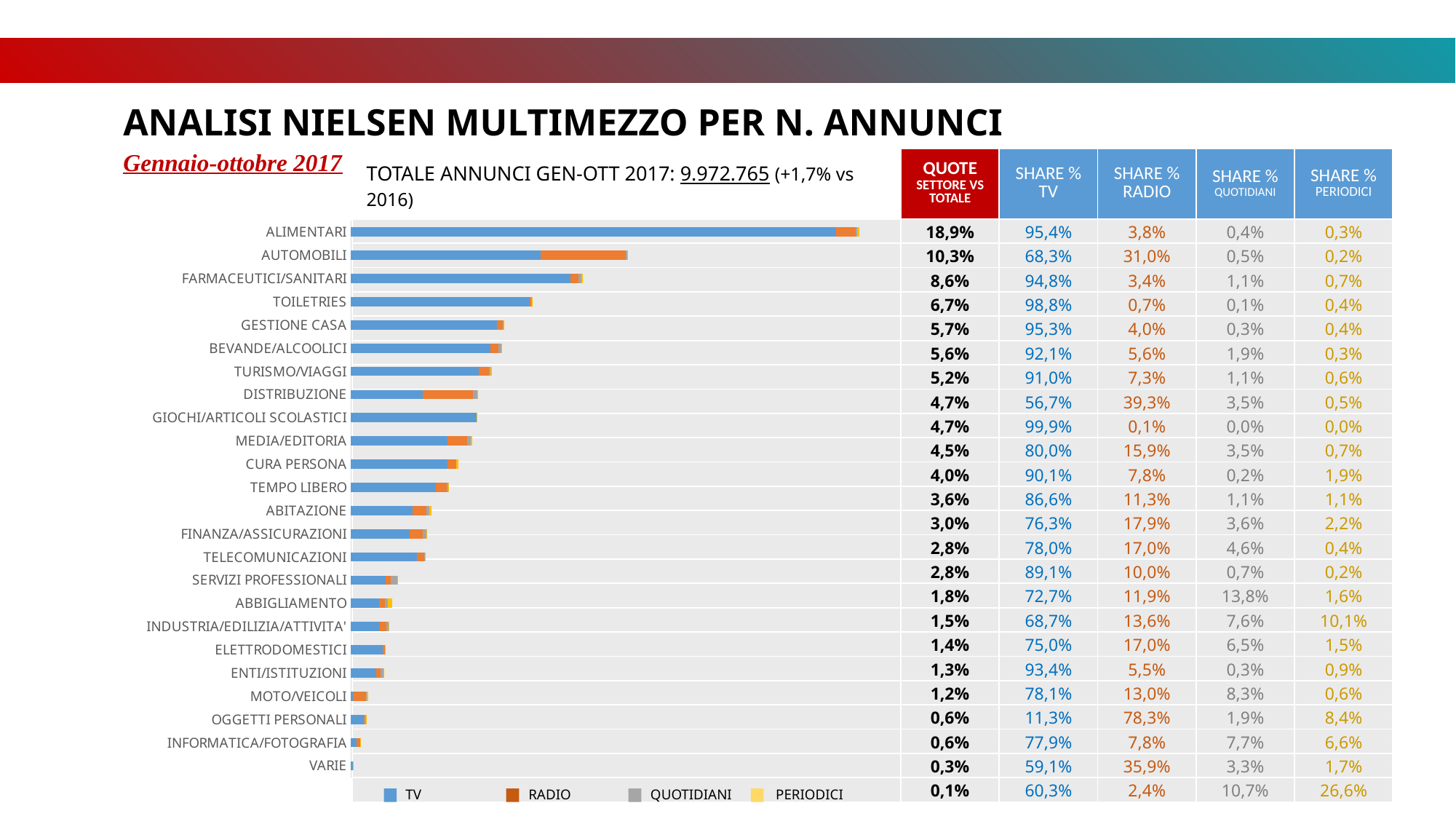
Which category has a longer bar, TOILETRIES or GESTIONE CASA? TOILETRIES How many series does the chart legend list? 4 Do the bar lengths increase or decrease going from the top category to the bottom category? Decrease Which category has the longest bar in the chart? ALIMENTARI Which series are listed in the chart legend? TV, RADIO, QUOTIDIANI, PERIODICI What total number of announcements for GEN-OTT 2017 is stated above the chart? 9.972.765 According to the table next to the chart, what is the QUOTE SETTORE VS TOTALE for ALIMENTARI? 18,9% According to the table next to the chart, what is the SHARE % TV for AUTOMOBILI? 68,3% According to the table next to the chart, what is the SHARE % RADIO for DISTRIBUZIONE? 39,3% Which category has a longer bar, AUTOMOBILI or FARMACEUTICI/SANITARI? AUTOMOBILI What kind of chart is shown on the slide? Stacked horizontal bar chart What is the difference between the QUOTE SETTORE VS TOTALE of ALIMENTARI (18,9%) and AUTOMOBILI (10,3%)? 8,6%